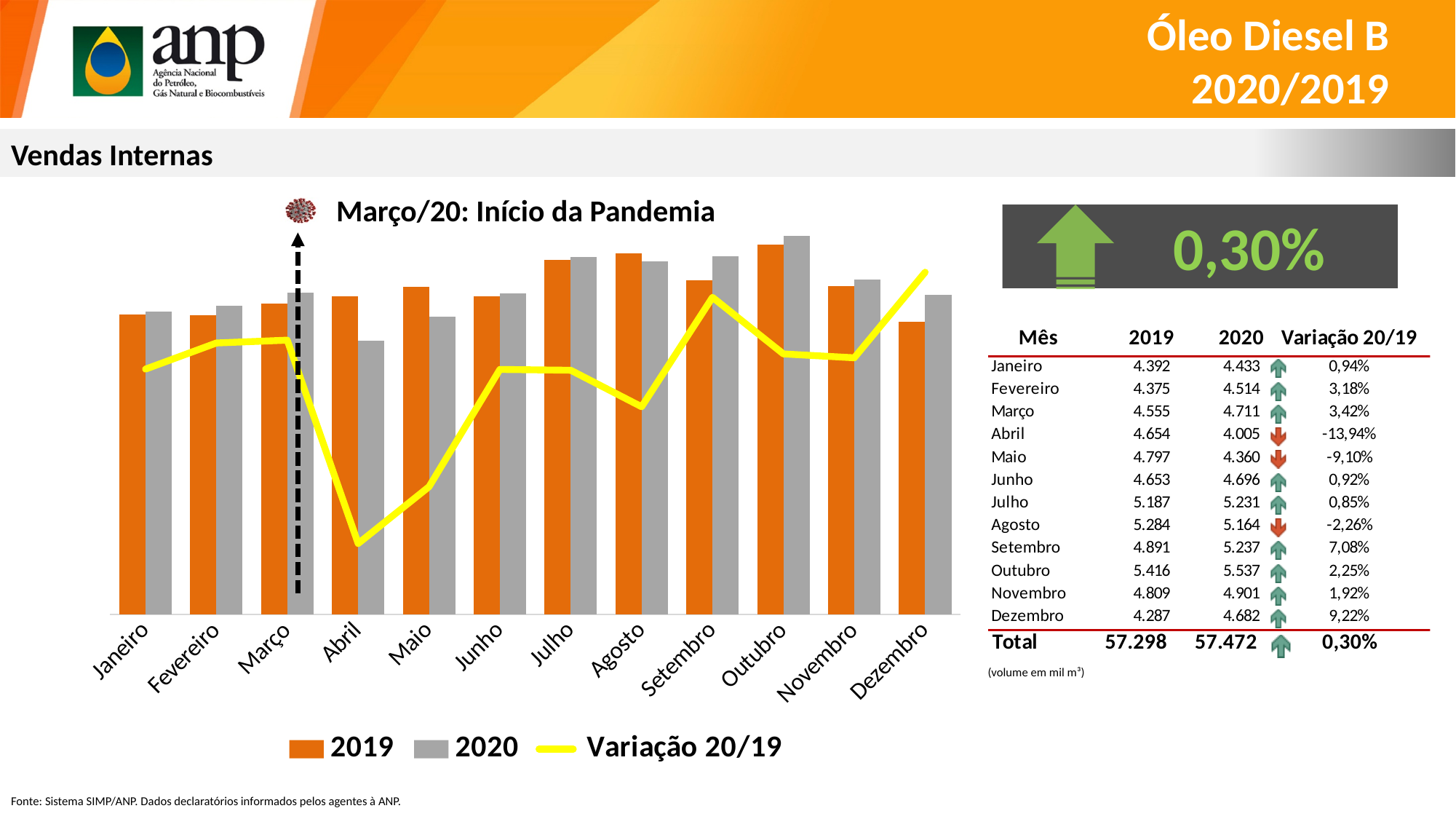
Which is larger for Maio, the 2019 bar or the 2020 bar? 2019 Which month has the lowest Variação 20/19? Abril Which month has the highest 2020 value? Outubro Does the Variação 20/19 line rise or fall from Março to Abril? Fall What was the 2019 value for Outubro? 5.416 What was the 2020 value for Abril? 4.005 What is the difference between the 2020 and 2019 values for Dezembro? 395 What kind of chart is shown on the slide? Combined bar and line chart How many months are shown on the x axis of the chart? 12 What is the Variação 20/19 for Setembro? 7,08% What event is annotated at Março on the chart? Março/20: Início da Pandemia How many series does the chart legend list? 3